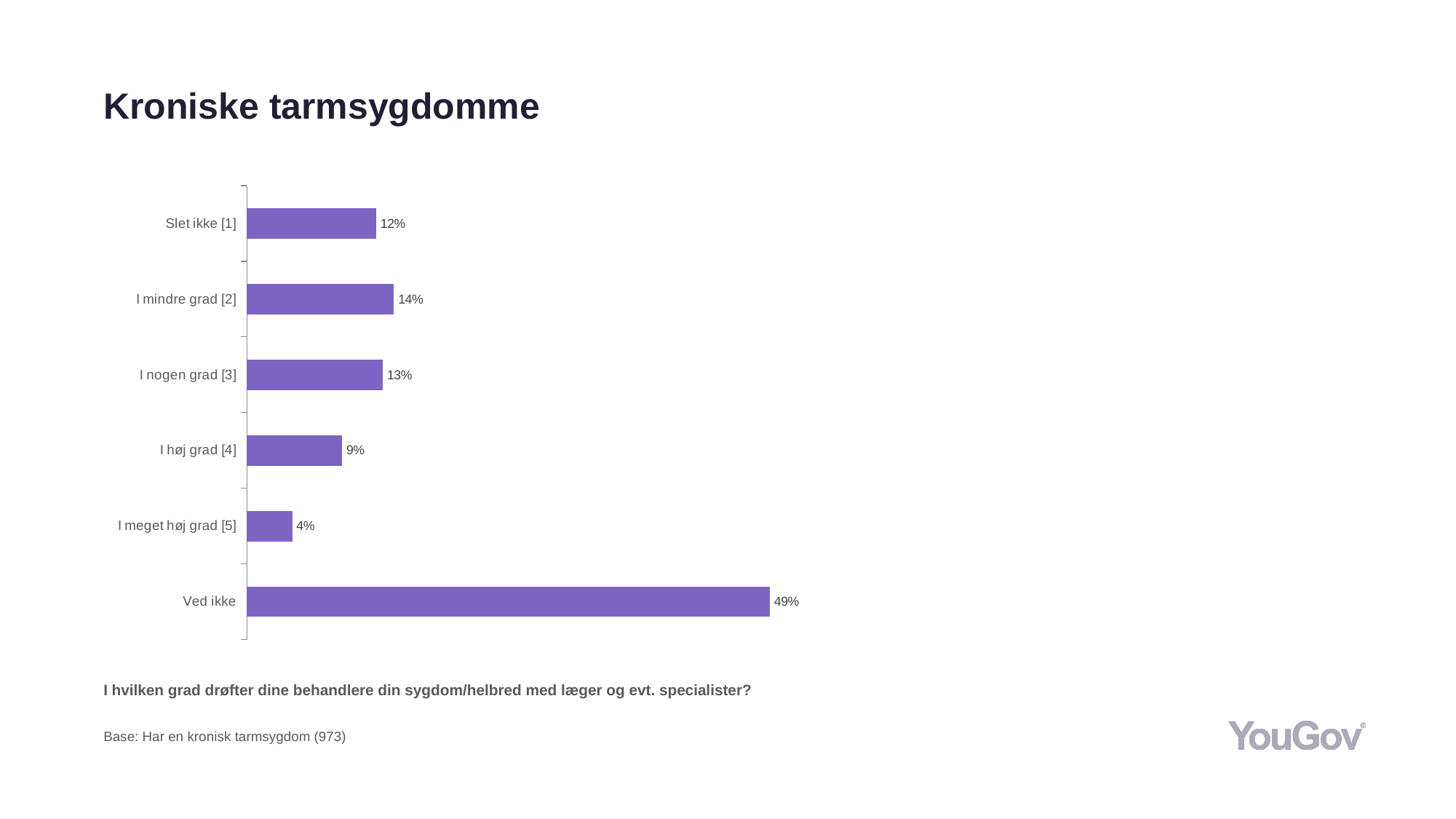
What is the value for "I mindre grad [2]"? 14% What is the value for "I meget høj grad [5]"? 4% What is the base (number of respondents) stated below the chart? 973 What is the value for "Ved ikke"? 49% What is the difference between the values for "Ved ikke" and "I høj grad [4]"? 40% What kind of chart is shown on the slide? Bar chart How many categories are shown in the chart? 6 What is the value for "Slet ikke [1]"? 12% Which category has the highest value? Ved ikke Which is larger, the value for "I nogen grad [3]" or the value for "I høj grad [4]"? I nogen grad [3] Which category has the lowest value? I meget høj grad [5] What is the difference between the values for "I mindre grad [2]" and "Slet ikke [1]"? 2%